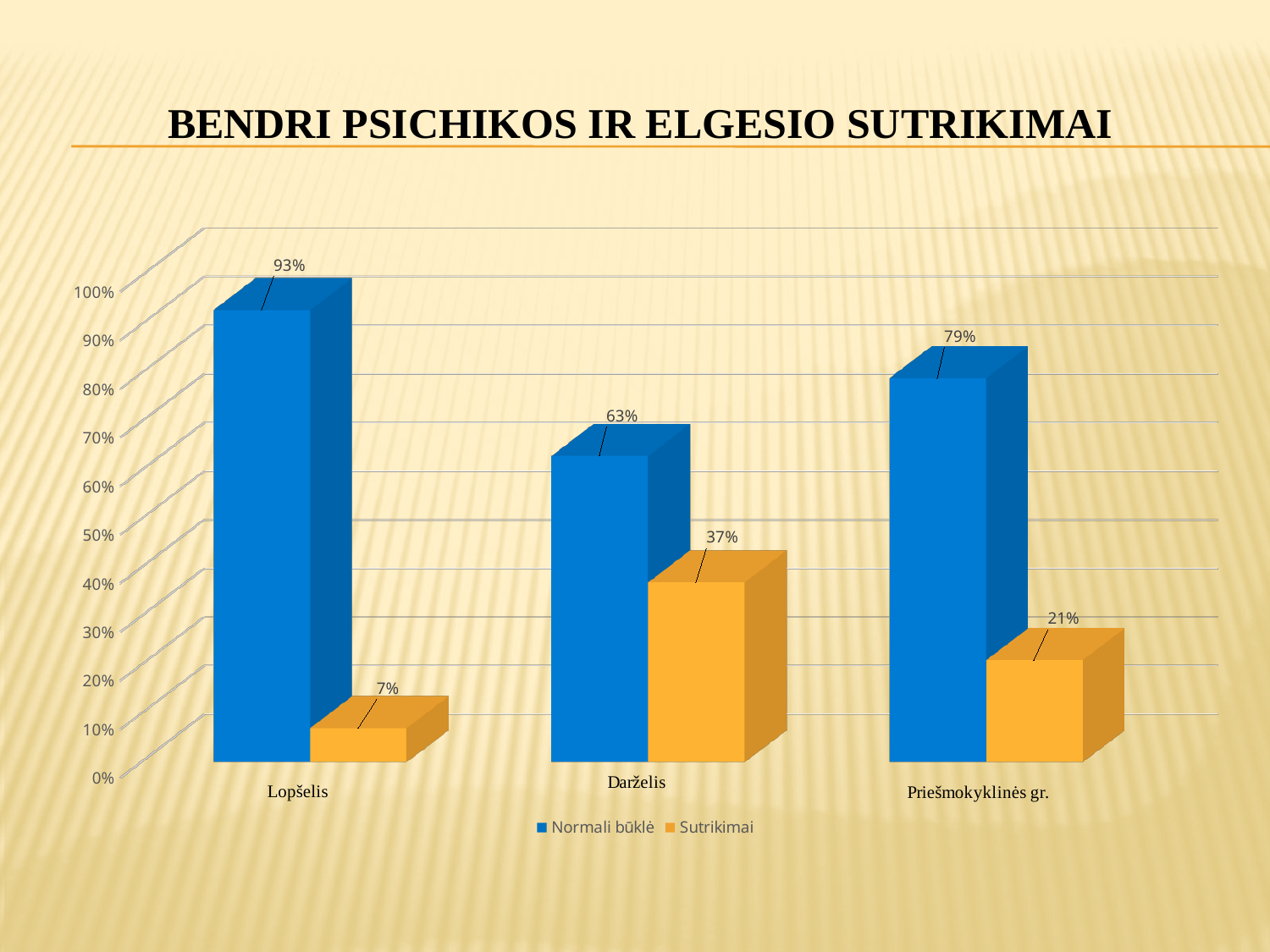
What is the value for Sutrikimai in the Priešmokyklinės gr. category? 21% What is the value for Normali būklė in the Lopšelis category? 93% Which is larger: Sutrikimai for Lopšelis or Sutrikimai for Priešmokyklinės gr.? Priešmokyklinės gr. Which category has the highest value for Sutrikimai? Darželis Which category has the lowest value for Normali būklė? Darželis What is the difference between Normali būklė and Sutrikimai in the Priešmokyklinės gr. category? 58% What kind of chart is shown on the slide? Bar chart How many series does the legend list? 2 What is the title of the chart on the slide? BENDRI PSICHIKOS IR ELGESIO SUTRIKIMAI Which colour represents the Sutrikimai series? Orange What is the value for Sutrikimai in the Darželis category? 37% How many categories are shown on the x axis? 3